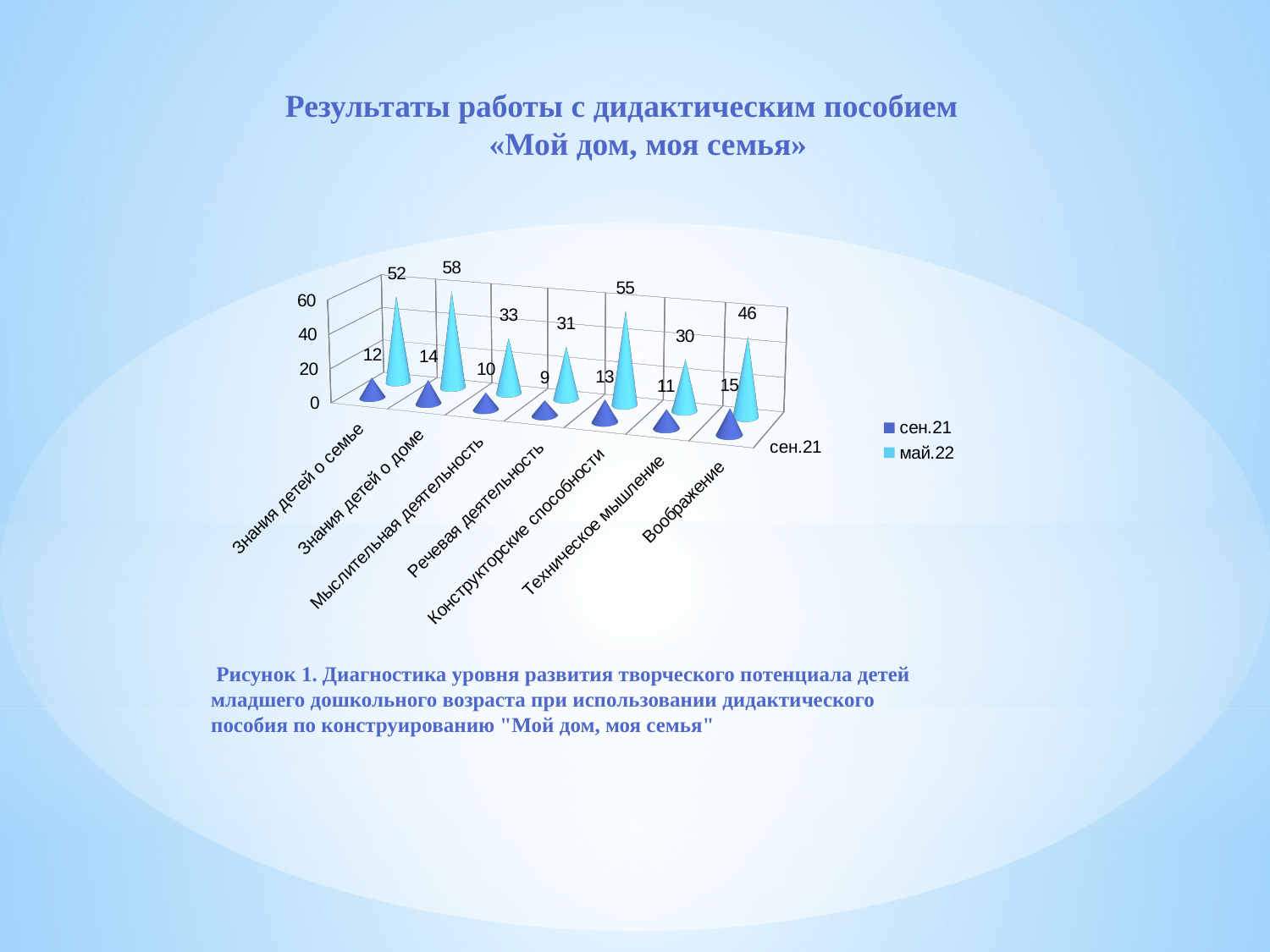
How many series does the legend list? 2 What is the value for Речевая деятельность in the сен.21 series? 9 Which category has the lowest value in the сен.21 series? Речевая деятельность What is the difference between the май.22 and сен.21 values for Конструкторские способности? 42 How many categories are shown on the x axis? 7 What is the value for Мыслительная деятельность in the май.22 series? 33 What is the value for Воображение in the май.22 series? 46 What is the value for Знания детей о доме in the май.22 series? 58 Which category has the highest value in the май.22 series? Знания детей о доме What are the two series names listed in the legend? сен.21 and май.22 Which is larger for Техническое мышление: the сен.21 value or the май.22 value? май.22 What kind of chart is shown on the slide? 3D bar chart (cone-shaped bars)